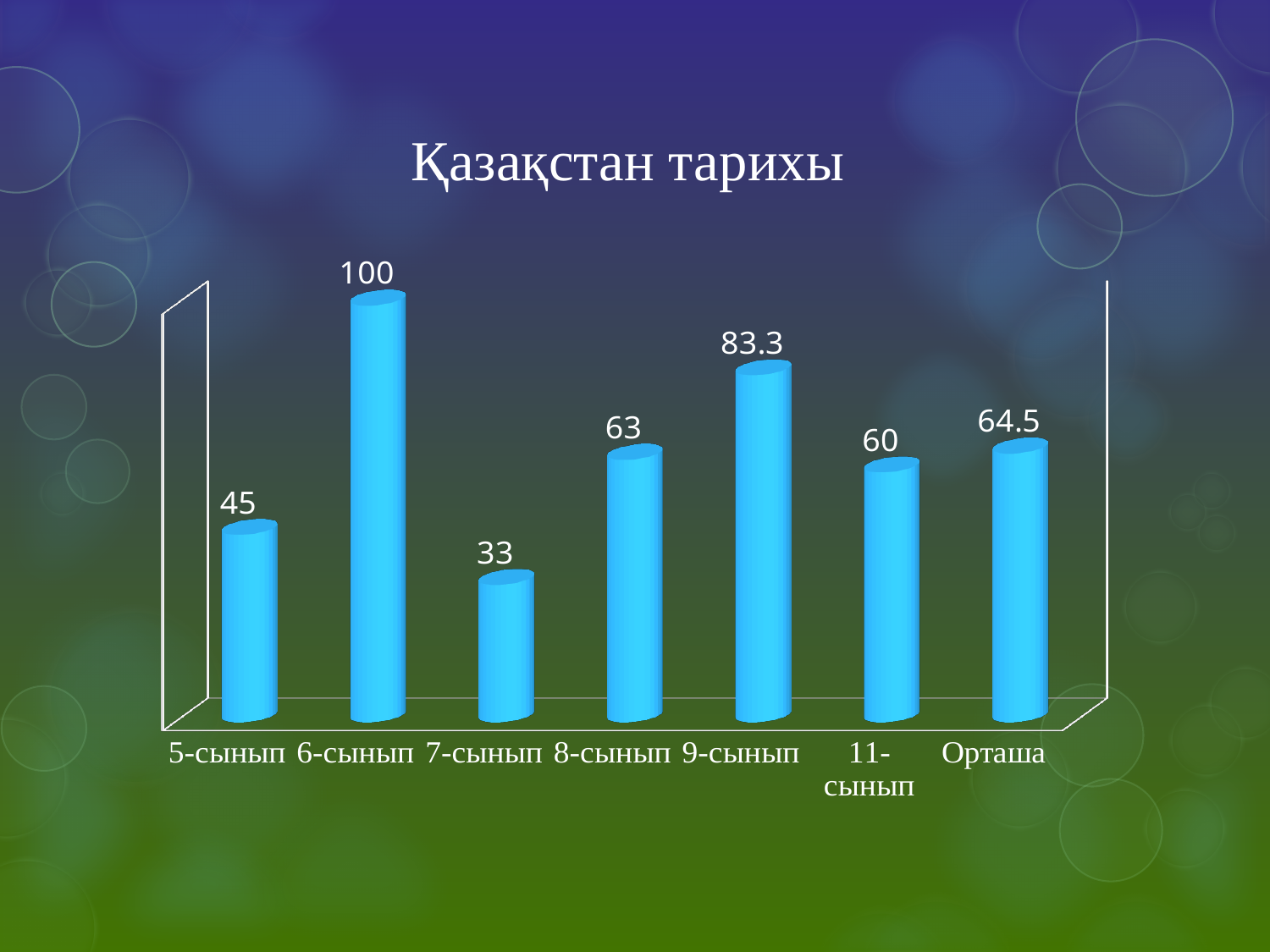
What is the value for 11-сынып? 60 What kind of chart is shown on the slide? bar chart What is the value for 6-сынып? 100 Which category has the highest value? 6-сынып Which category has the lowest value? 7-сынып What is the value for Орташа? 64.5 What is the difference between the values for 6-сынып and 7-сынып? 67 What is the title of the chart? Қазақстан тарихы How many categories are shown on the x axis? 7 Which is larger, the value for 5-сынып or the value for 8-сынып? 8-сынып What is the difference between the values for 9-сынып and 8-сынып? 20.3 What is the value for 9-сынып? 83.3